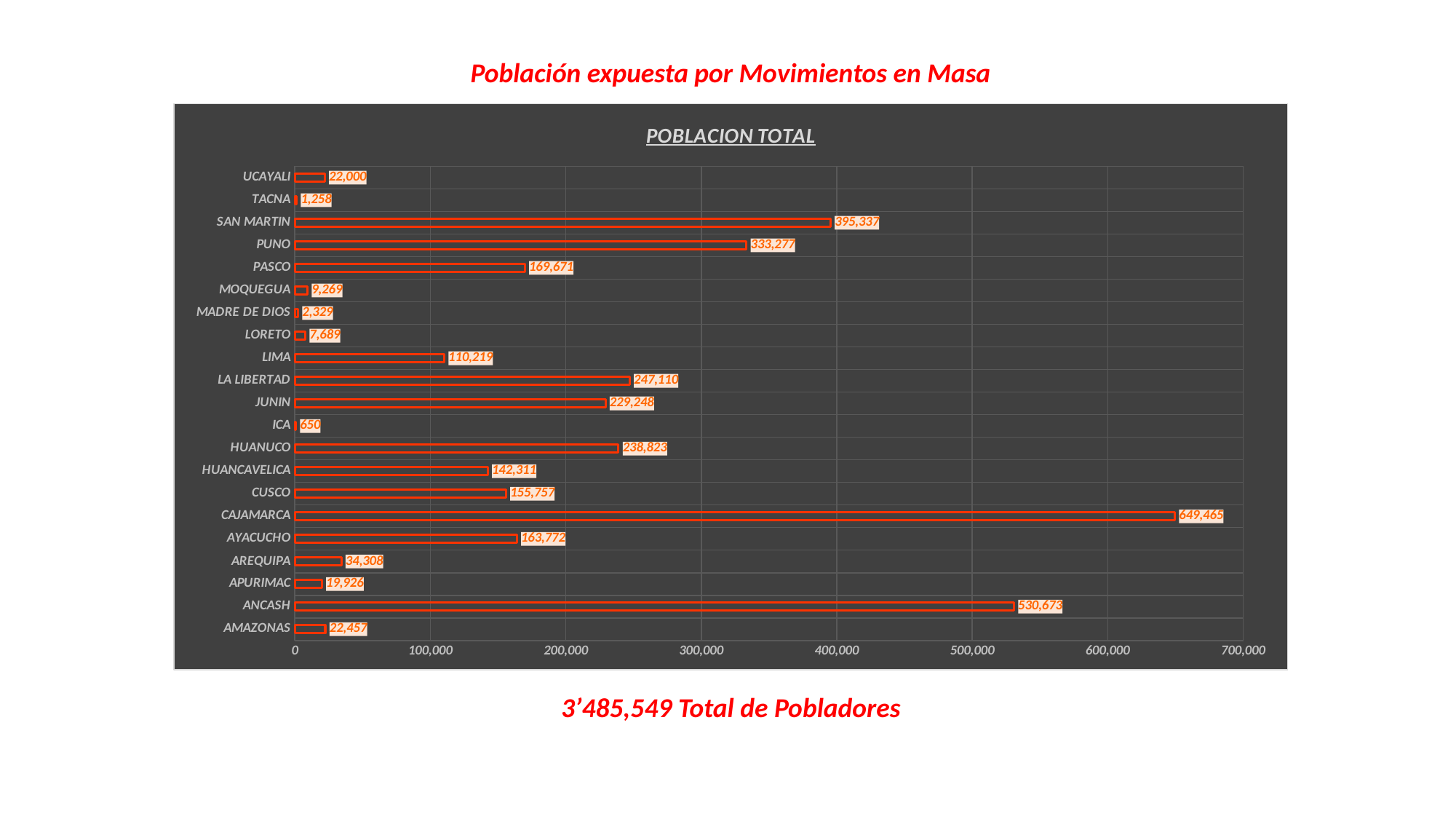
Which category has the highest value? CAJAMARCA Which category has the lowest value? ICA What is the difference between the values for CAJAMARCA and ANCASH? 118,792 What is the title of the chart? POBLACION TOTAL How many categories are shown in the chart? 21 What kind of chart is shown on the slide? Bar chart Which is larger, the value for HUANUCO or the value for JUNIN? HUANUCO Is the value for ANCASH greater or less than 500,000? greater What is the difference between the values for SAN MARTIN and PUNO? 62,060 What is the value for MADRE DE DIOS? 2,329 What is the value for CAJAMARCA? 649,465 What is the value for LIMA? 110,219